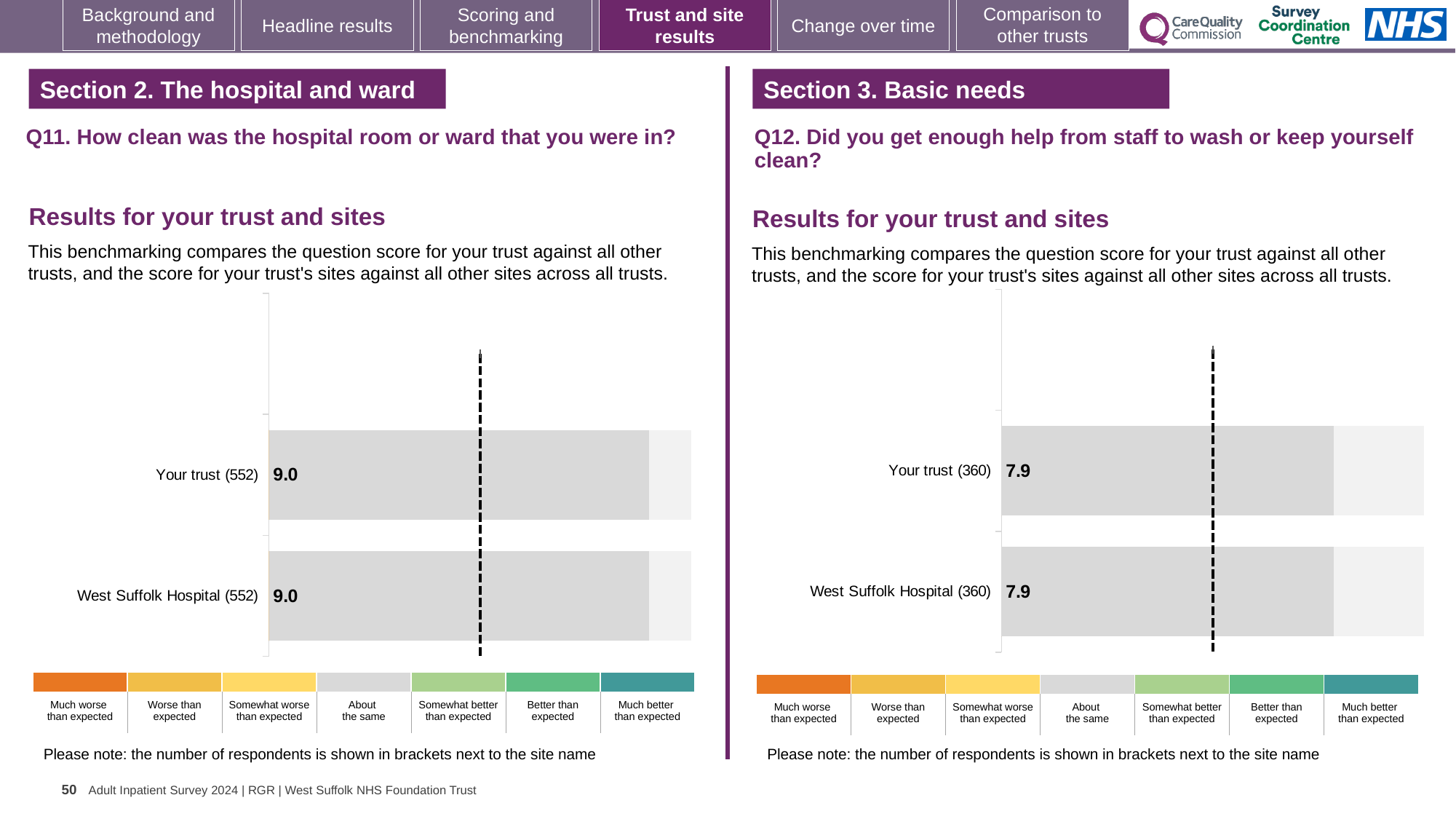
In the Q11 chart (How clean was the hospital room or ward), what is the score for West Suffolk Hospital? 9.0 In the Q12 chart (Did you get enough help from staff to wash or keep yourself clean), what is the score for Your trust? 7.9 How many bars are plotted in the Q11 chart? 2 In the Q12 chart, how many respondents are shown in brackets next to West Suffolk Hospital? 360 In the Q12 chart, what is the difference between the score for Your trust and the score for West Suffolk Hospital? 0.0 In the Q11 chart (How clean was the hospital room or ward), what is the score for Your trust? 9.0 In the Q12 chart (Did you get enough help from staff to wash or keep yourself clean), what is the score for West Suffolk Hospital? 7.9 In the Q11 chart, how many respondents are shown in brackets next to Your trust? 552 In the Q11 chart, what is the difference between the score for Your trust and the score for West Suffolk Hospital? 0.0 How many bars are plotted in the Q12 chart? 2 How many categories does the colour key below the Q12 chart list? 7 What kind of chart is used for the Q11 results? Bar chart